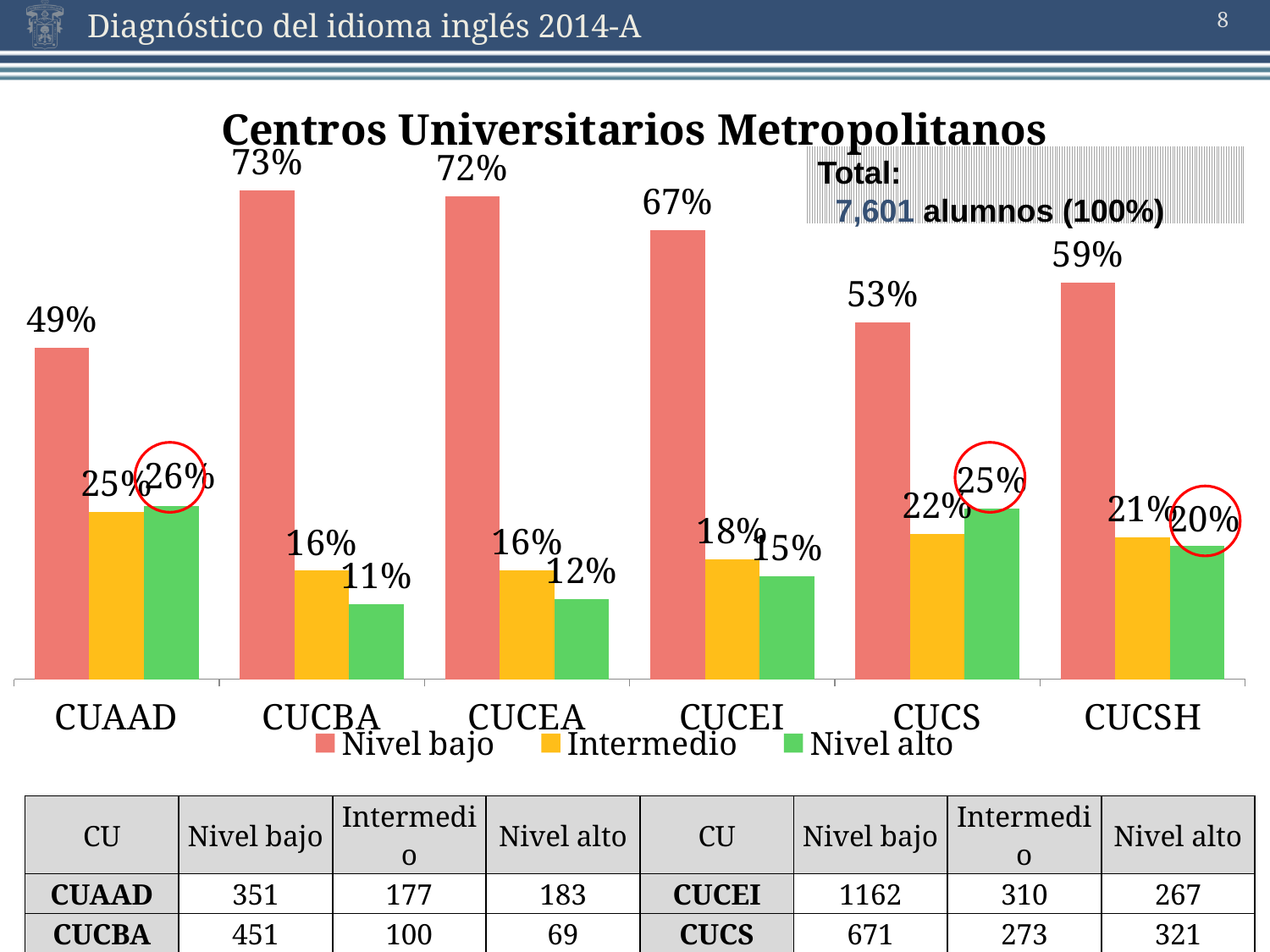
Which centro universitario has the lowest Nivel alto value? CUCBA Which is larger, the Nivel alto value for CUCS or the Nivel alto value for CUCEI? CUCS Which centro universitario has the highest Nivel bajo value? CUCBA What kind of chart is shown on the slide? Bar chart How many centros universitarios are shown on the x axis of the chart? 6 How many series does the chart legend list? 3 What is the Nivel bajo value for CUCBA? 73% What is the title of the chart? Centros Universitarios Metropolitanos What is the Nivel bajo value for CUCSH? 59% What is the difference between the Nivel bajo values for CUCBA and CUAAD? 24% What is the Nivel alto value for CUAAD? 26% What is the Intermedio value for CUCS? 22%